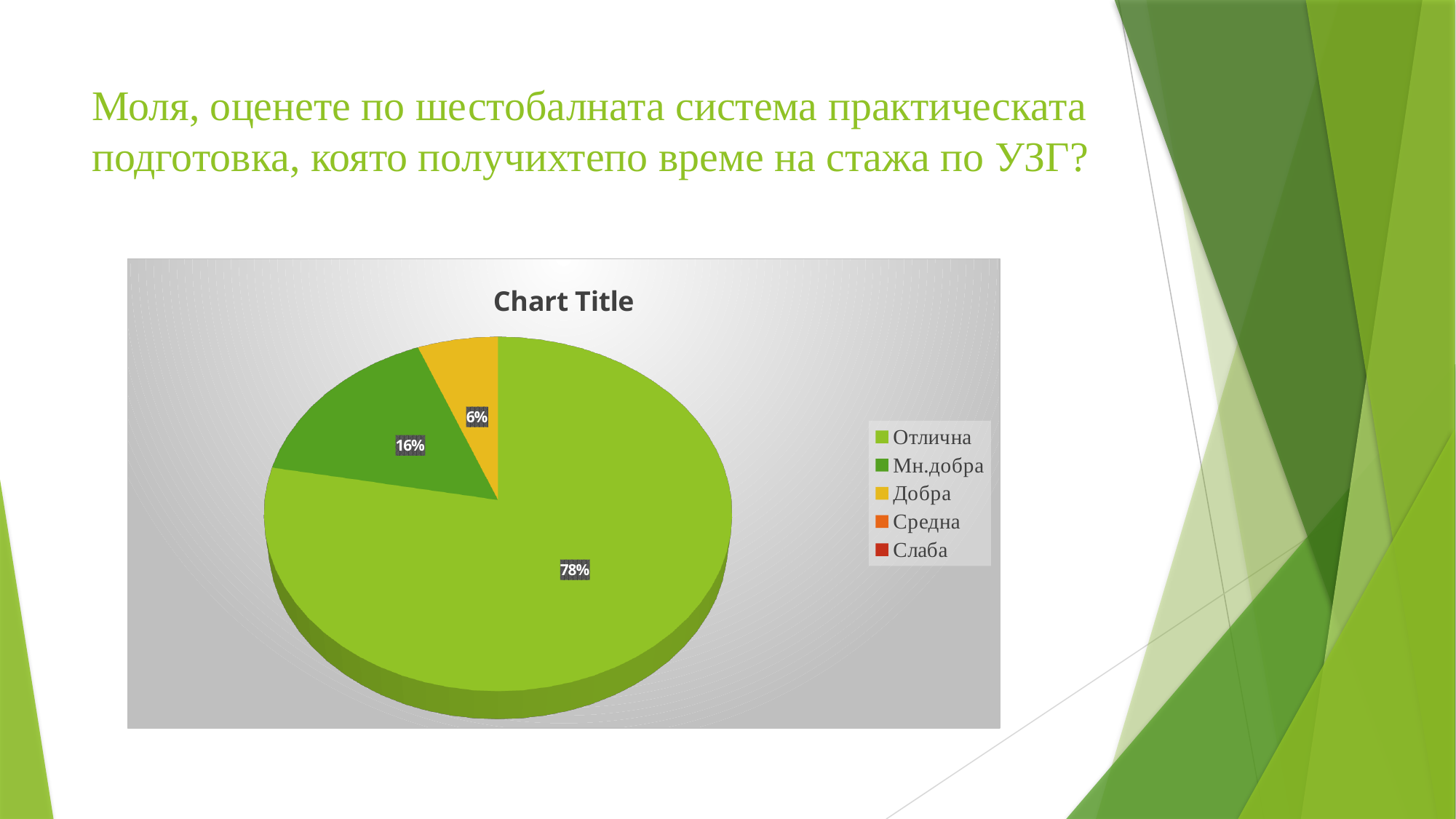
Which legend entry is shown in yellow? Добра How many entries does the legend list? 5 Which slice is larger, Мн.добра or Добра? Мн.добра What share of the pie does Отлична have? 78% What share of the pie does Мн.добра have? 16% What is the title shown on the chart? Chart Title What share of the pie does Добра have? 6% Which of the visible slices is the smallest? Добра What is the difference in percentage points between the Отлична and Мн.добра slices? 62 Which category has the largest slice of the pie? Отлична What kind of chart is shown on the slide? pie chart What is the difference in percentage points between the Мн.добра and Добра slices? 10